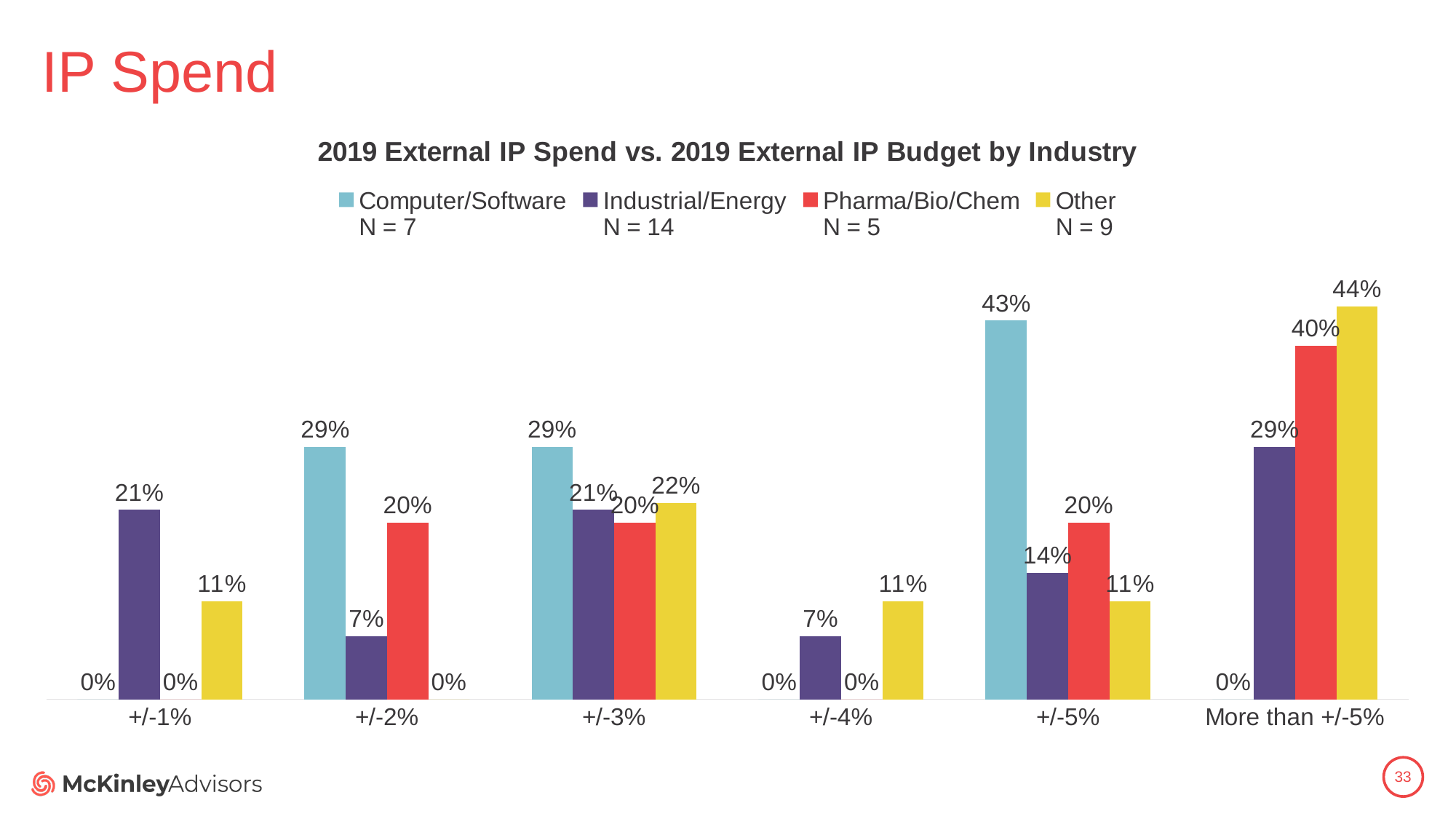
What kind of chart is shown on the slide? Bar chart How many categories are shown on the x axis? 6 What is the value for Industrial/Energy in the +/-1% category? 21% What is the sample size (N) shown in the legend for Industrial/Energy? N = 14 What is the difference between the Other and Pharma/Bio/Chem values in the More than +/-5% category? 4% What is the value for Computer/Software in the +/-5% category? 43% Which is larger in the +/-3% category: Industrial/Energy or Other? Other How many series does the legend list? 4 What is the value for Other in the More than +/-5% category? 44% In which category does Computer/Software have its highest value? +/-5% What is the value for Pharma/Bio/Chem in the +/-2% category? 20% Which series has the lowest value in the More than +/-5% category? Computer/Software